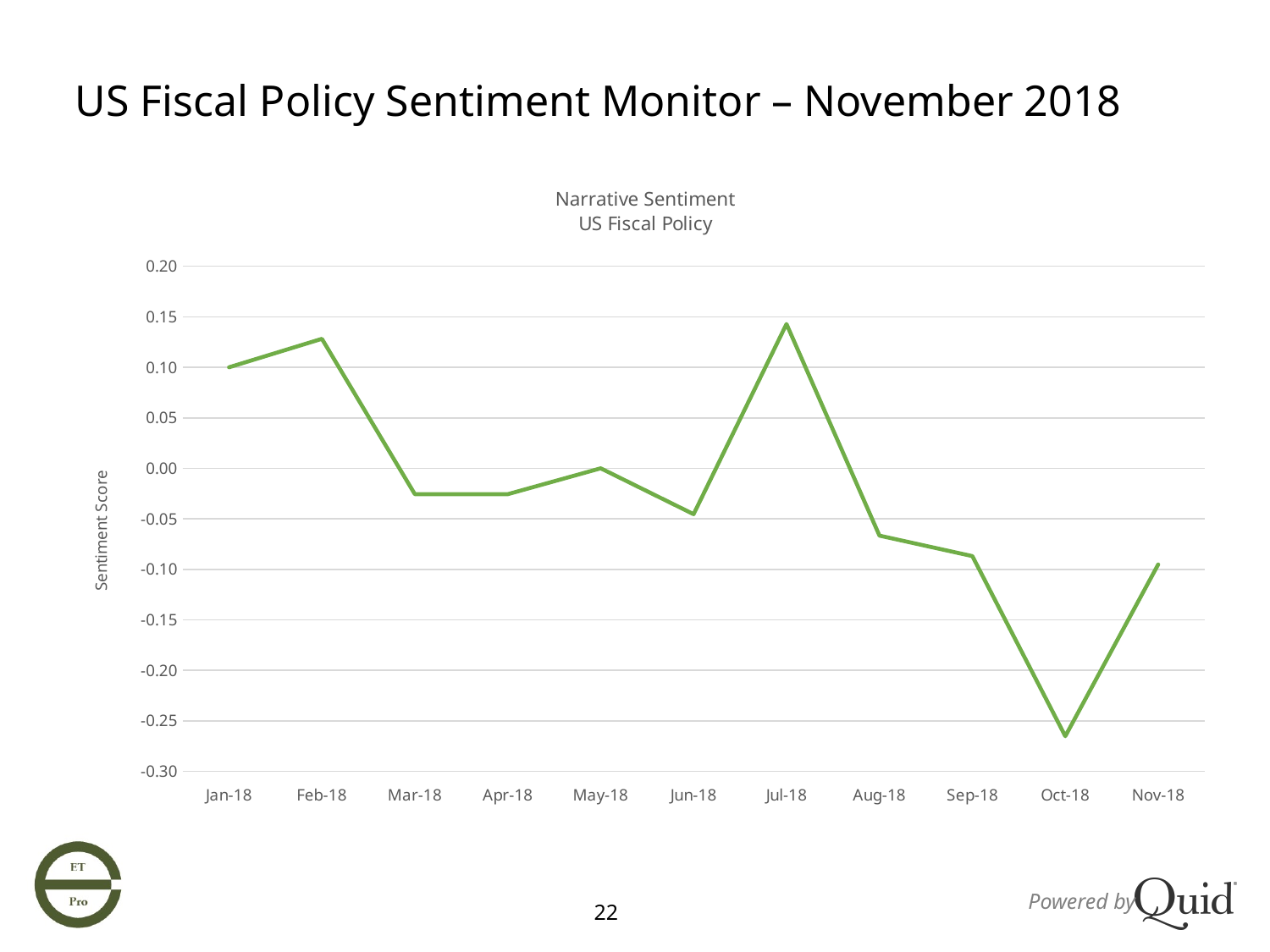
Is the sentiment score for Aug-18 greater or less than -0.05? less Is the sentiment score for Oct-18 greater or less than -0.25? less What kind of chart is shown on the slide? line chart How many monthly data points are plotted on the chart? 11 Does the sentiment score rise or fall from Jul-18 to Oct-18? fall Which month has the larger sentiment score, Jan-18 or Mar-18? Jan-18 Is the sentiment score for Feb-18 greater or less than 0.10? greater What is the label on the vertical axis of the chart? Sentiment Score Which month has the highest sentiment score? Jul-18 Which month has the lowest sentiment score? Oct-18